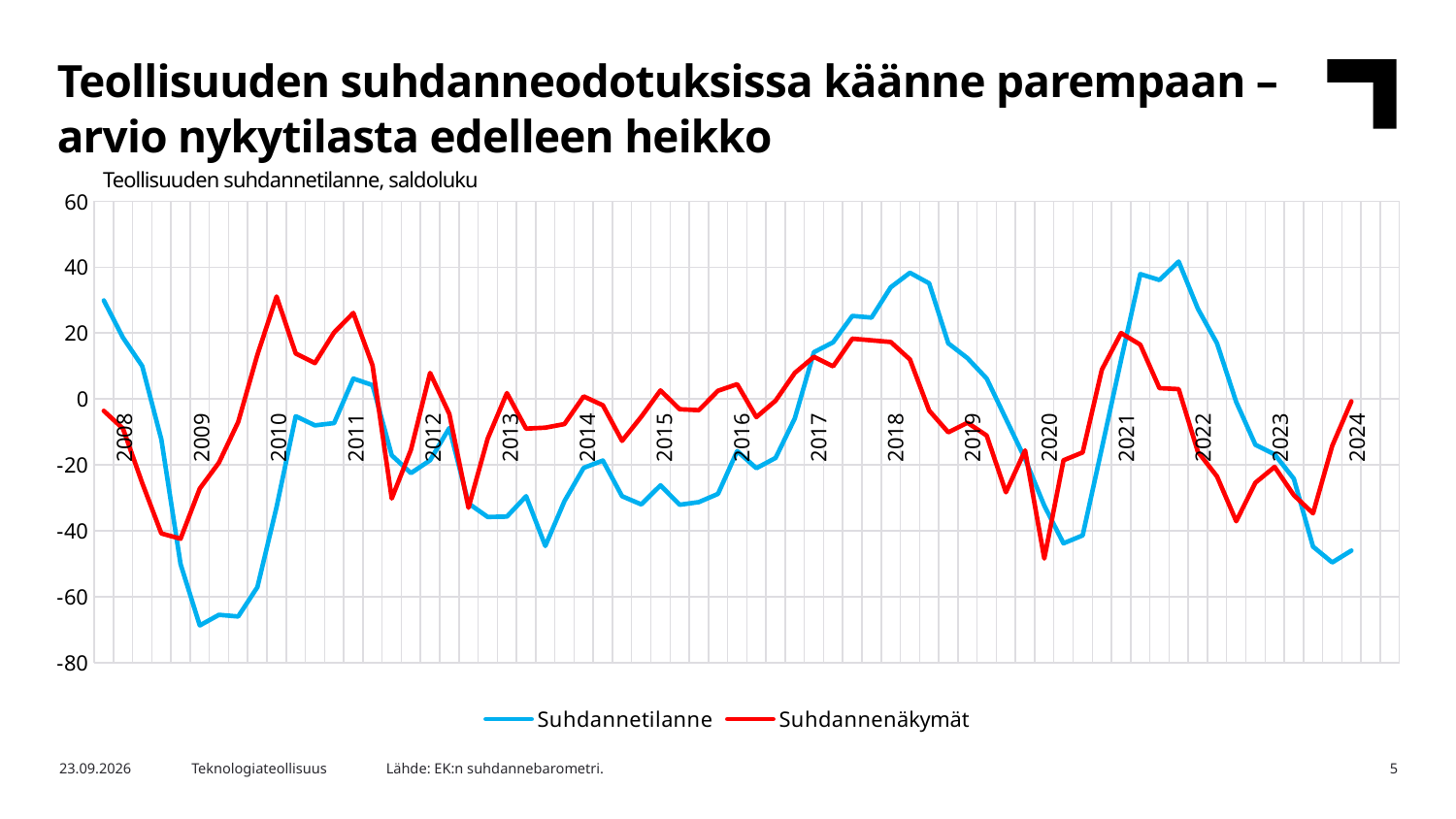
What kind of chart is shown on the slide? line chart How many year labels are shown on the x axis? 17 Around 2009, which series reaches the lower value, Suhdannetilanne or Suhdannenäkymät? Suhdannetilanne At the end of the series in 2024, which series has the higher value, Suhdannetilanne or Suhdannenäkymät? Suhdannenäkymät Is the lowest value of the Suhdannetilanne series, around 2009, greater or less than -60? less How many series does the legend list? 2 Is the lowest value of the Suhdannenäkymät series around 2020 greater or less than -40? less Does the Suhdannetilanne series rise or fall between 2021 and 2023? fall What are the two series named in the legend? Suhdannetilanne and Suhdannenäkymät Is the peak of the Suhdannenäkymät series around 2010 greater or less than 20? greater What is the subtitle printed above the chart? Teollisuuden suhdannetilanne, saldoluku